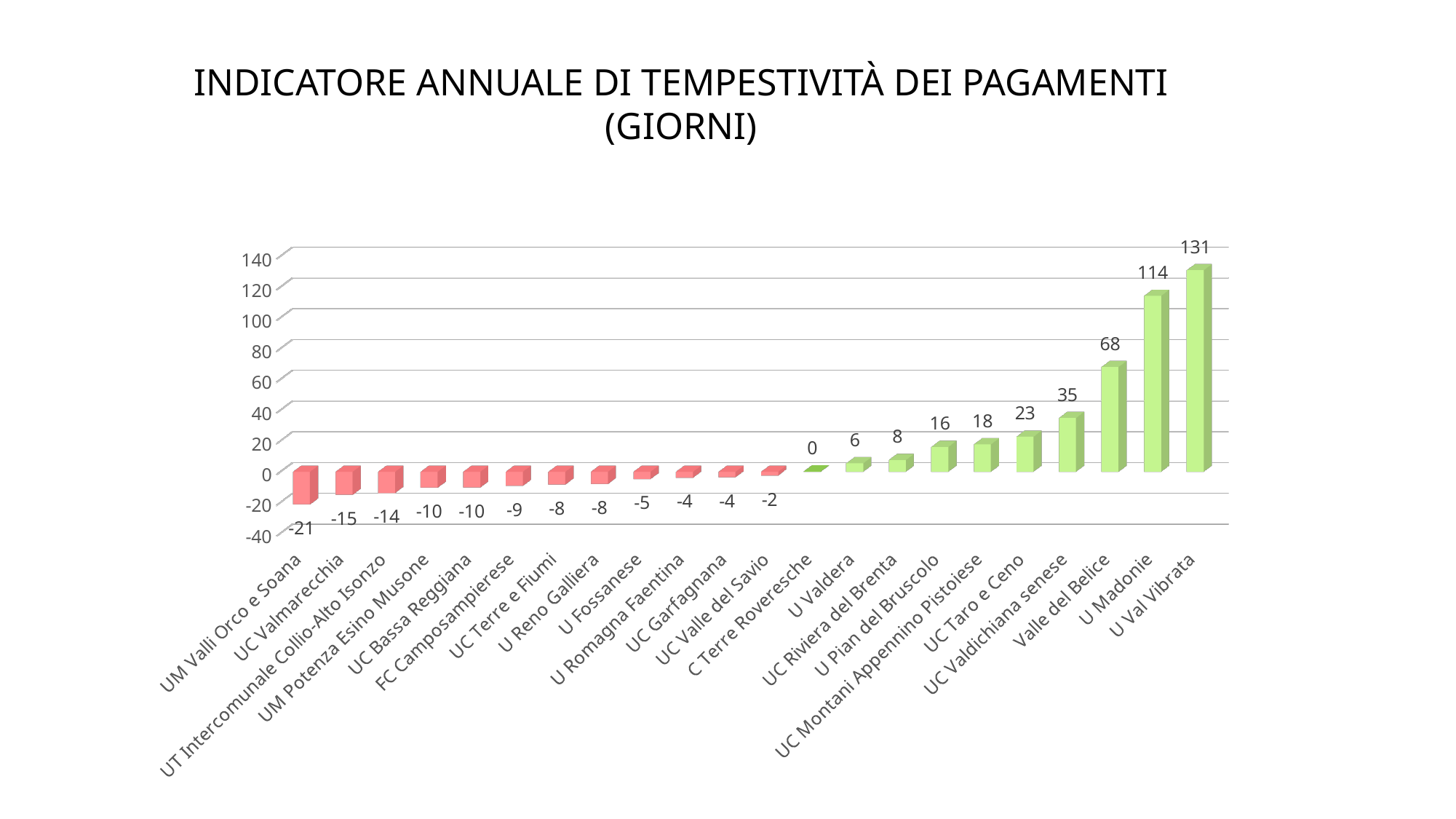
What is the value for C Terre Roveresche? 0 What is the value for UC Taro e Ceno? 23 Which category has the lowest value? UM Valli Orco e Soana What is the value for UM Valli Orco e Soana? -21 Which category has the highest value? U Val Vibrata Which is larger, the value for Valle del Belice or the value for UC Valdichiana senese? Valle del Belice How many categories are shown on the x axis? 22 What kind of chart is shown on the slide? Bar chart Do the values rise or fall from left to right along the x axis? Rise What is the difference between the values for U Val Vibrata and U Madonie? 17 What is the title of the chart? INDICATORE ANNUALE DI TEMPESTIVITÀ DEI PAGAMENTI (GIORNI) What is the value for U Madonie? 114